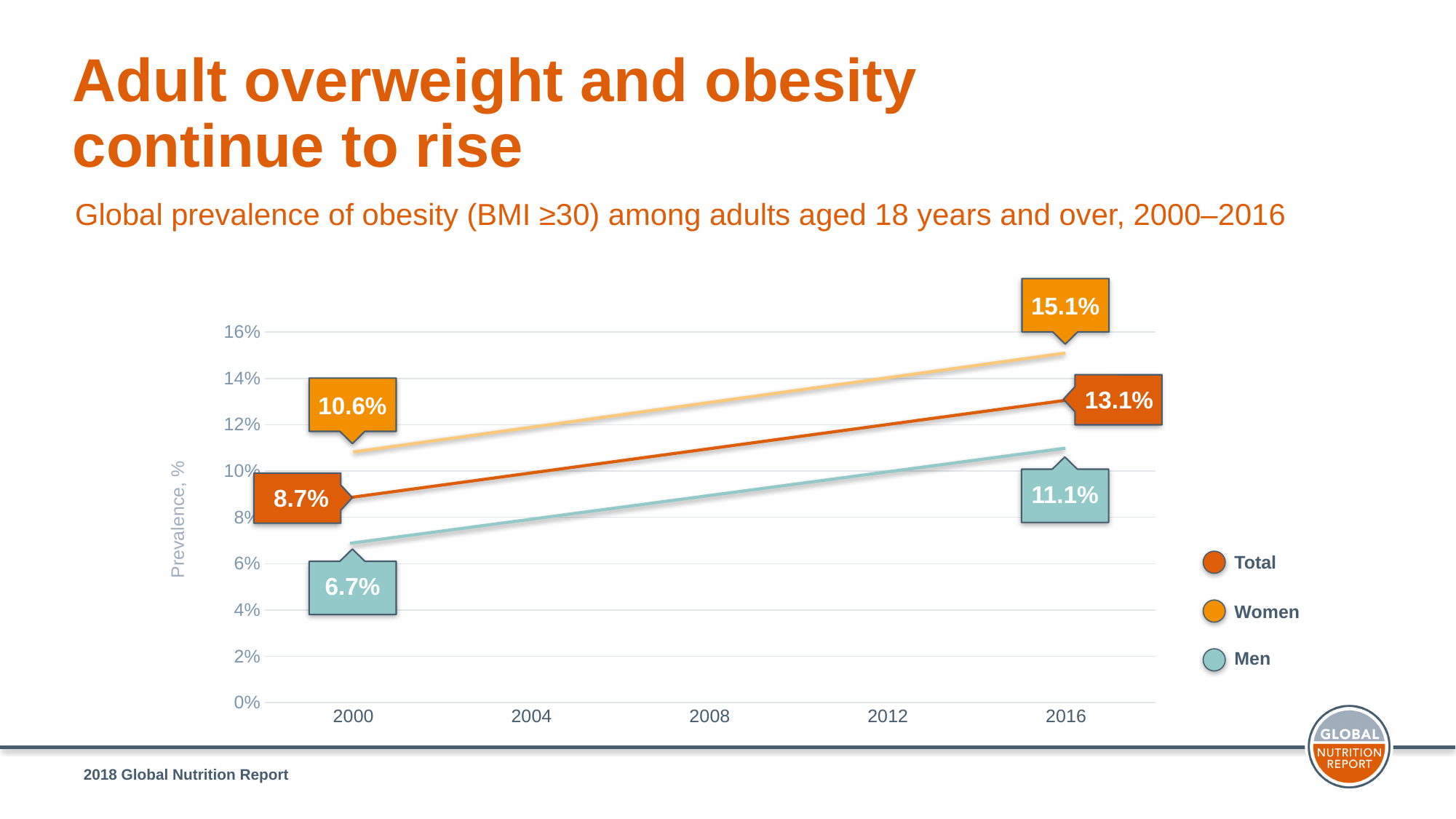
What kind of chart is shown on the slide? Line chart What was the obesity prevalence for Men in 2000? 6.7% How many series does the legend list? 3 Do the obesity prevalence values rise or fall from 2000 to 2016? Rise Which series had the lowest obesity prevalence in 2000? Men What is the difference between the Women and Men obesity prevalence in 2016? 4.0 percentage points By how many percentage points did the Total obesity prevalence change from 2000 to 2016? 4.4 percentage points What was the obesity prevalence for Women in 2016? 15.1% Which series had the highest obesity prevalence in 2016? Women What was the Total obesity prevalence in 2016? 13.1% Which was larger in 2000: the Total prevalence or the Men prevalence? Total What was the obesity prevalence for Women in 2000? 10.6%